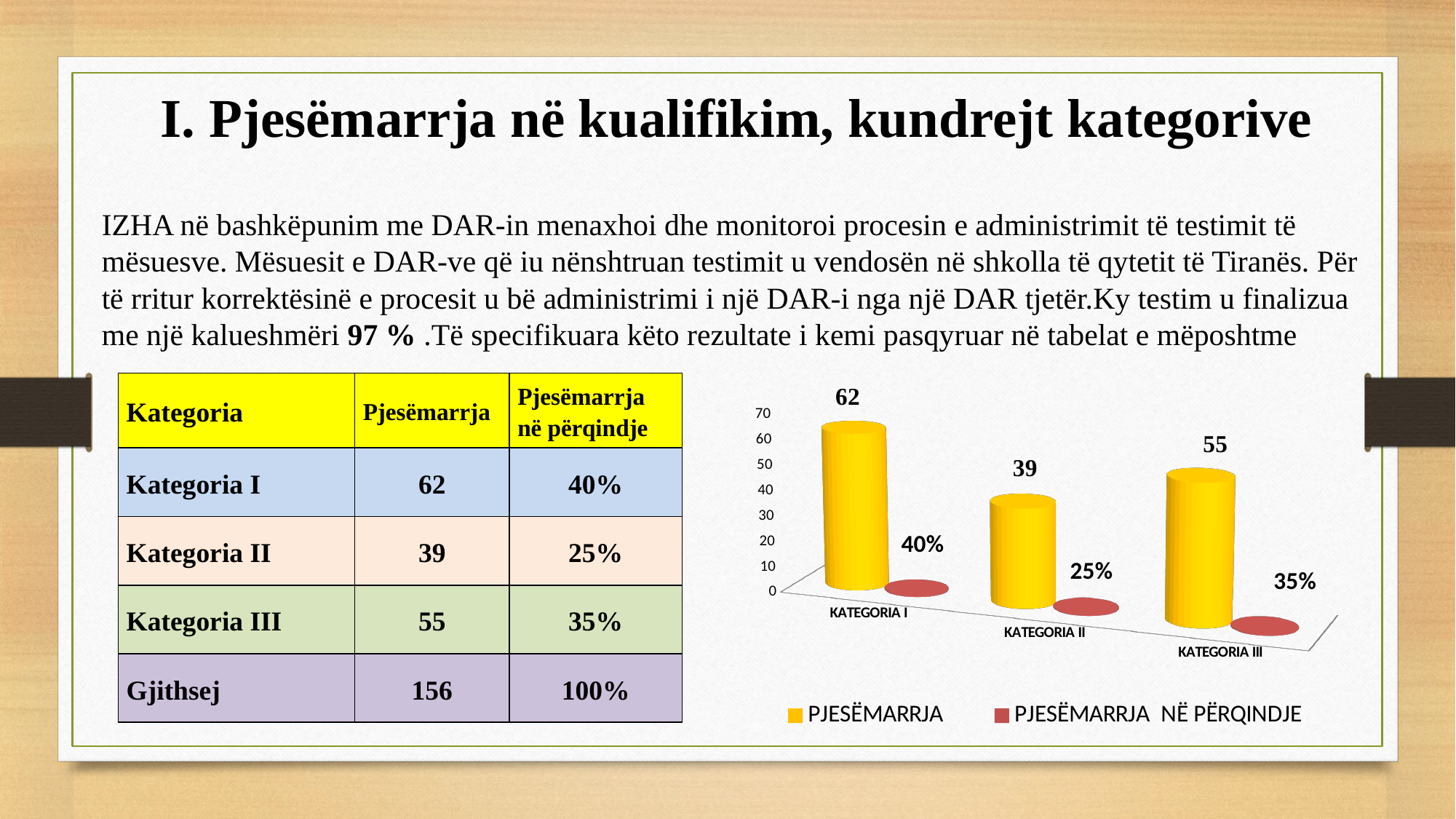
What colour are the PJESËMARRJA bars in the chart? yellow What is the PJESËMARRJA value for KATEGORIA I in the chart? 62 Which category has the lowest PJESËMARRJA value in the chart? KATEGORIA II How many series does the chart legend list? 2 What kind of chart is shown on the slide? bar chart Which has a larger PJESËMARRJA value, KATEGORIA II or KATEGORIA III? KATEGORIA III Is the PJESËMARRJA value for KATEGORIA II greater or less than 50? less What is the PJESËMARRJA value for KATEGORIA II in the chart? 39 How many categories are shown on the x axis of the chart? 3 What is the PJESËMARRJA NË PËRQINDJE value for KATEGORIA III in the chart? 35% What is the difference between the PJESËMARRJA values for KATEGORIA I and KATEGORIA III? 7 Which category has the highest PJESËMARRJA value in the chart? KATEGORIA I